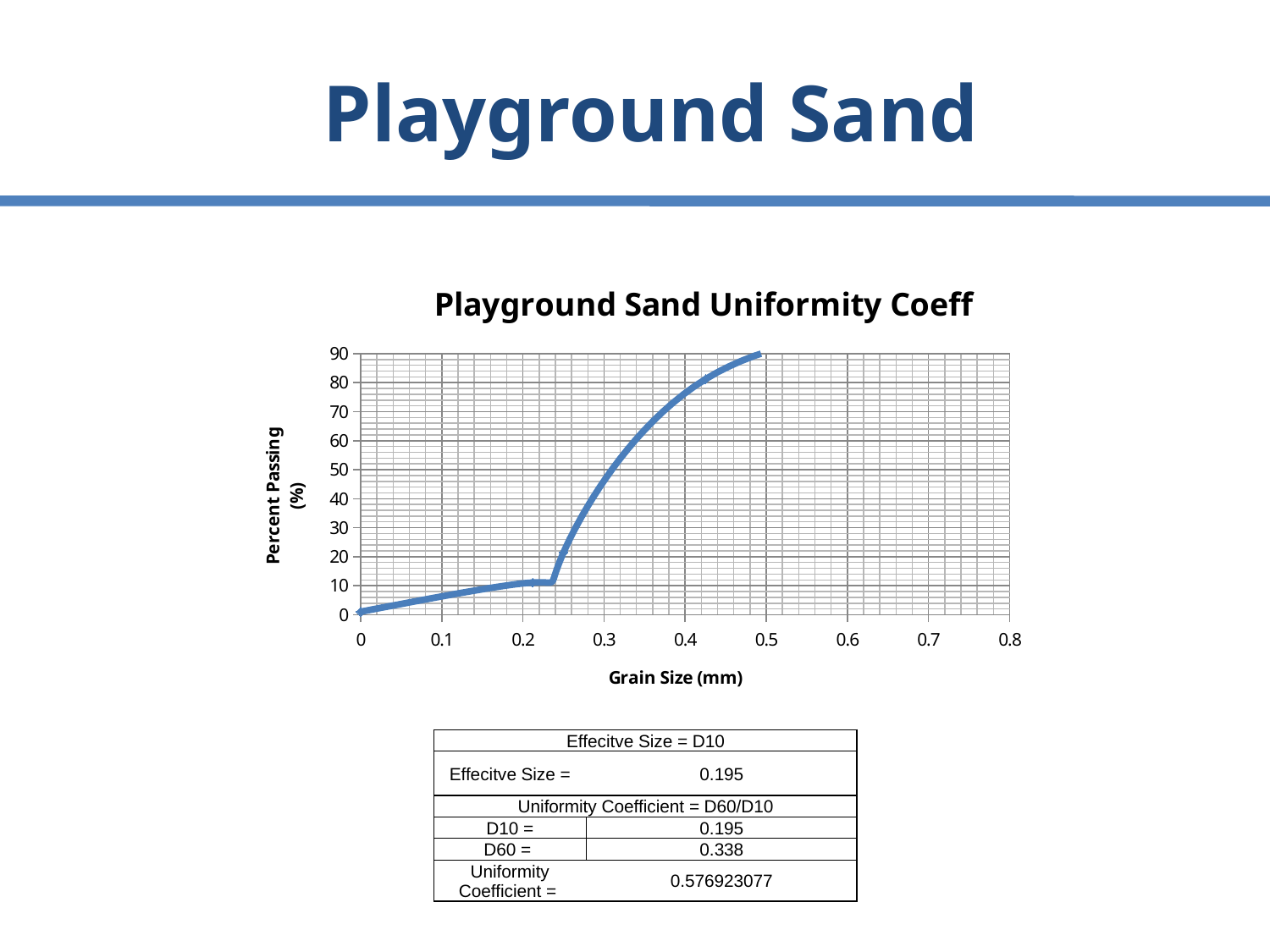
Is the Percent Passing value at a grain size of 0.4 mm greater or less than 70? greater What is the label of the x axis of the chart? Grain Size (mm) What is the highest tick value shown on the y axis of the chart? 90 Is the Percent Passing value at a grain size of 0.35 mm greater or less than 50? greater Is the Percent Passing value at a grain size of 0.25 mm greater or less than 30? less Do the values of Percent Passing rise or fall as Grain Size increases along the x axis? rise What is the title of the chart? Playground Sand Uniformity Coeff Which is larger, the Percent Passing value at a grain size of 0.2 mm or at 0.3 mm? 0.3 mm What kind of chart is shown on the slide? line chart